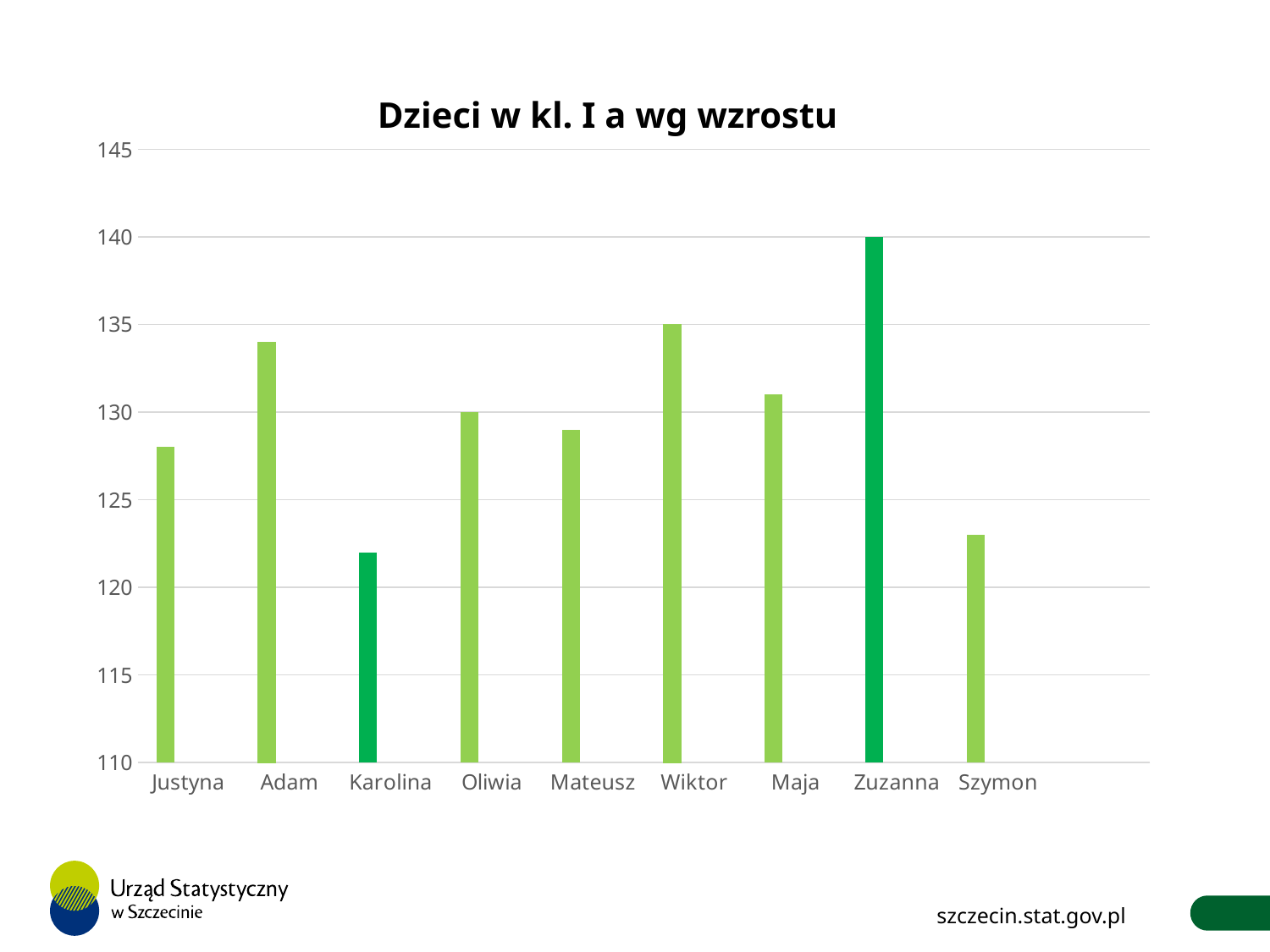
Is the value for Justyna greater or less than 125? greater Is the value for Szymon greater or less than 125? less Which is larger, the value for Adam or the value for Maja? Adam What is the title of the chart? Dzieci w kl. I a wg wzrostu What kind of chart is shown on the slide? bar chart What is the value for Zuzanna? 140 How many children (categories) are shown on the x axis? 9 What is the value for Wiktor? 135 What is the difference between the values for Zuzanna and Wiktor? 5 What is the value for Oliwia? 130 Which child has the lowest value? Karolina Which child has the highest value? Zuzanna